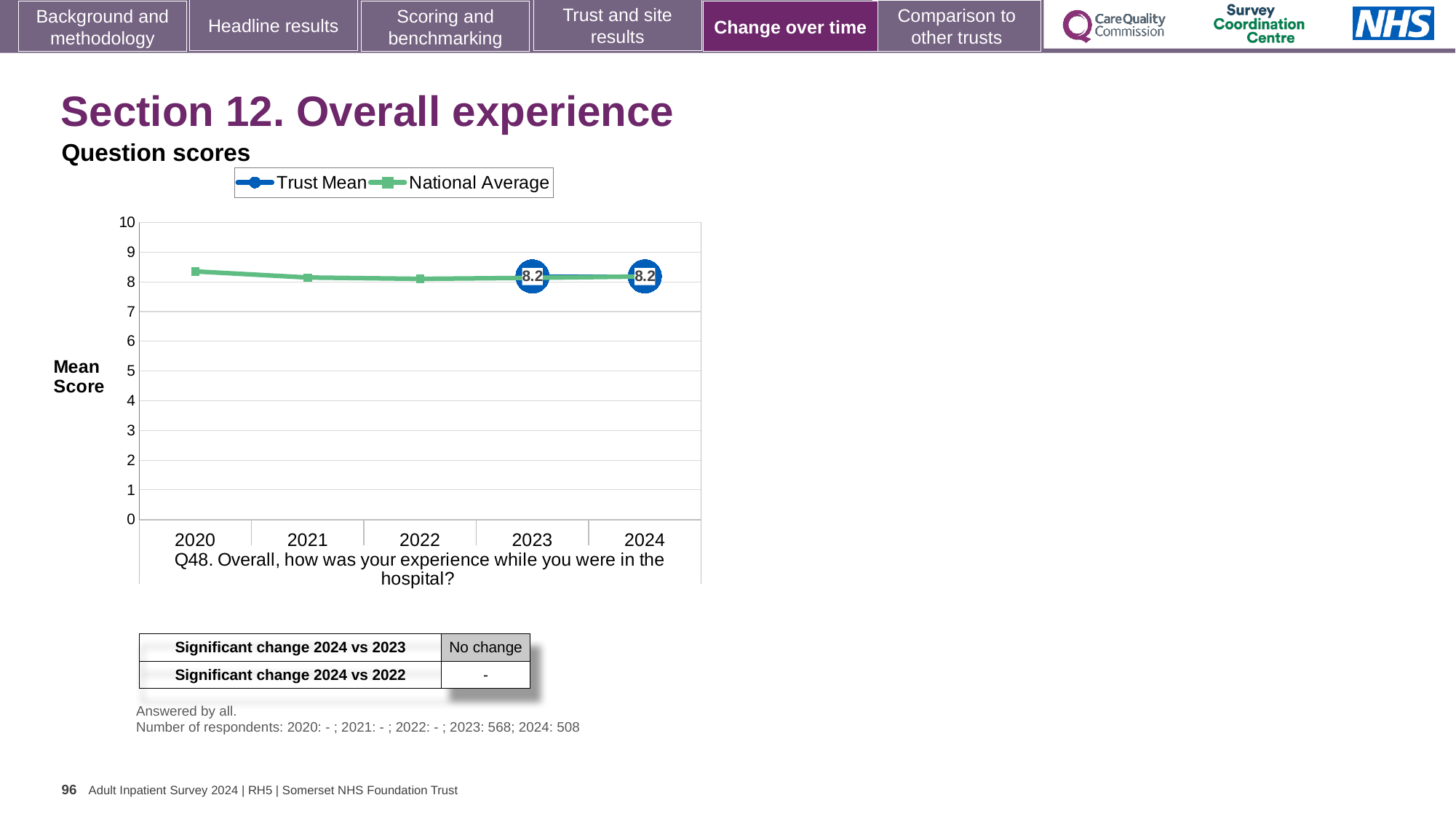
Is the National Average value for 2021 greater or less than 9? less What is the Trust Mean value for 2023? 8.2 Is the Trust Mean value for 2024 greater or less than 5? greater Is the National Average value for 2020 greater or less than 7? greater What is the Trust Mean value for 2024? 8.2 What kind of chart is shown on the slide? Line chart What is the difference between the Trust Mean values for 2024 and 2023? 0 How many years are shown along the x axis? 5 How many series does the legend list? 2 Which two series are listed in the chart legend? Trust Mean and National Average What is the label on the y axis of the chart? Mean Score